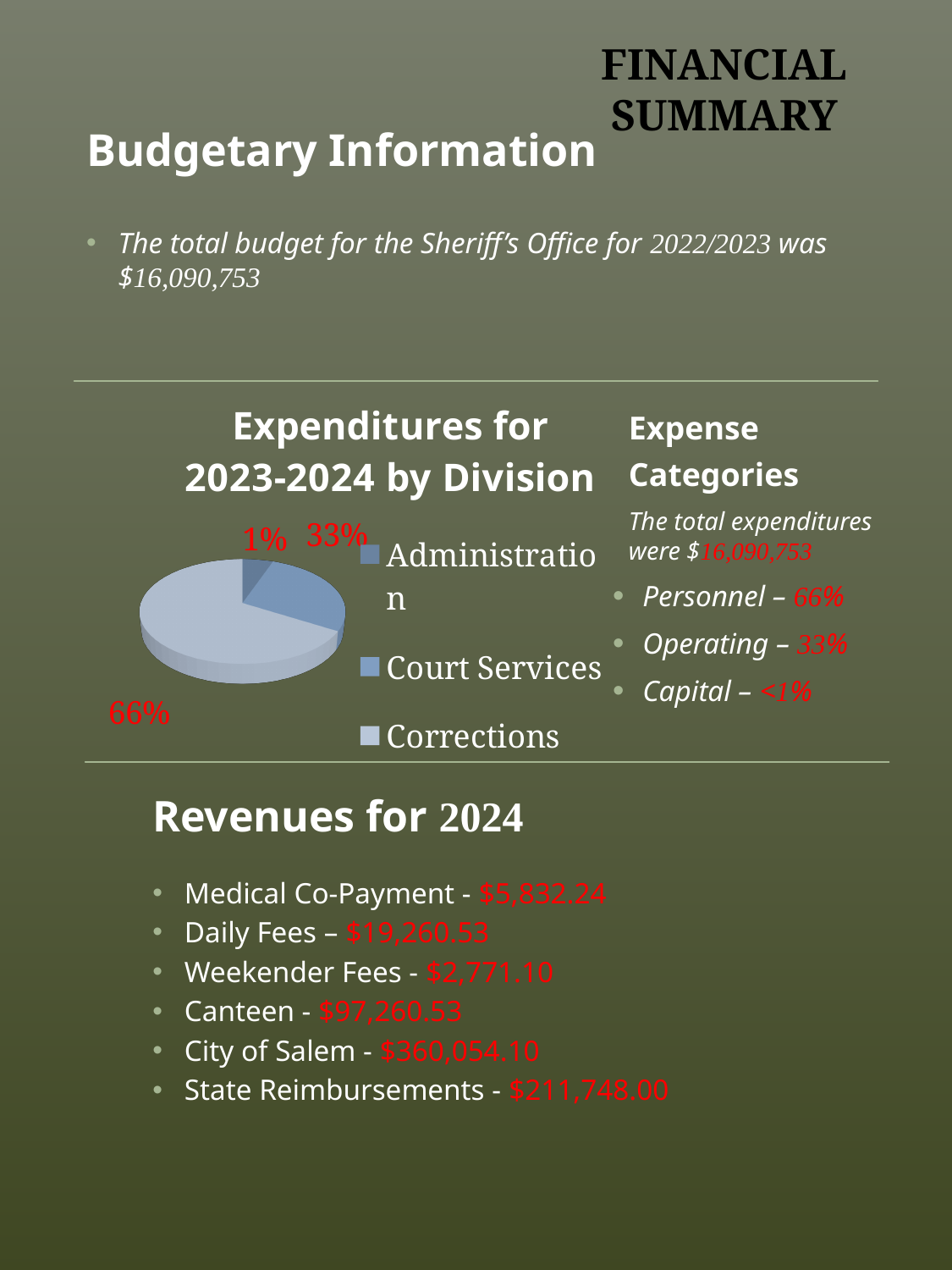
What are the three percentage labels shown on the 'Expenditures for 2023-2024 by Division' pie chart? 1%, 33%, 66% What is the title of the pie chart on the slide? Expenditures for 2023-2024 by Division What are the three legend entries of the 'Expenditures for 2023-2024 by Division' pie chart? Administration, Court Services, Corrections What is the smallest percentage labelled on the 'Expenditures for 2023-2024 by Division' pie chart? 1% Is the Corrections slice in the 'Expenditures for 2023-2024 by Division' pie chart greater or less than 50%? greater What kind of chart is shown under the title 'Expenditures for 2023-2024 by Division'? Pie chart Which division has the largest slice in the 'Expenditures for 2023-2024 by Division' pie chart? Corrections Which is larger in the 'Expenditures for 2023-2024 by Division' pie chart: the Corrections slice or the slice labelled 33%? Corrections How many divisions are shown in the 'Expenditures for 2023-2024 by Division' pie chart? 3 In the 'Expenditures for 2023-2024 by Division' pie chart, what is the difference in percentage points between the largest slice and the smallest slice? 65 What share of the 'Expenditures for 2023-2024 by Division' pie chart is Corrections? 66%